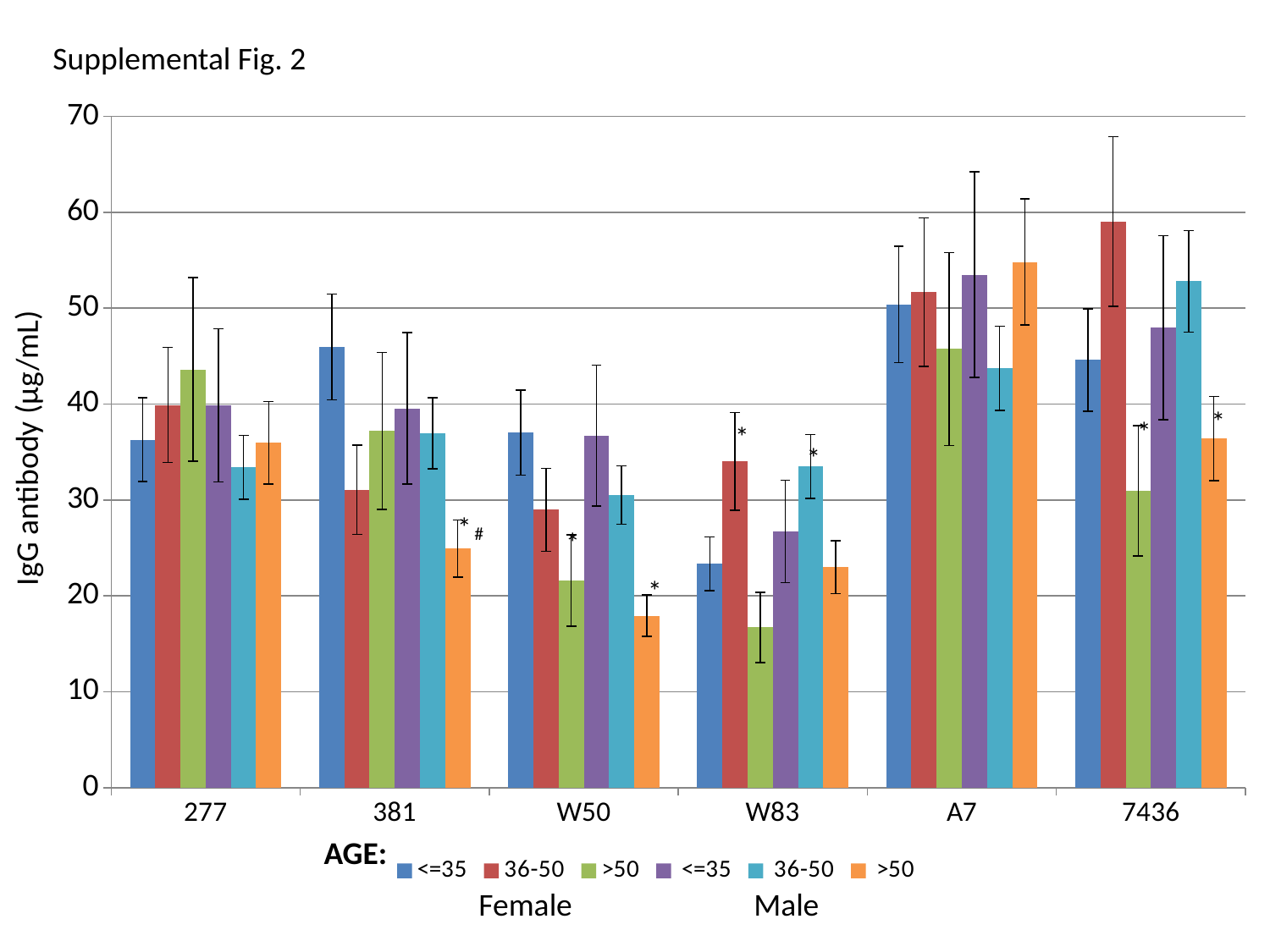
Is the value for the Male >50 series at W50 greater or less than 20? less Is the value for the Female >50 series at W83 greater or less than 20? less For the Male >50 series, which category has the highest value? A7 How many series does the legend list? 6 Is the value for the Female <=35 series at 381 greater or less than 40? greater At 7436, which is larger: the Female 36-50 value or the Female >50 value? Female 36-50 What kind of chart is shown on the slide? bar chart What is the label of the y axis? IgG antibody (µg/mL) For the Female >50 series, which category has the lowest value? W83 How many categories are shown on the x axis? 6